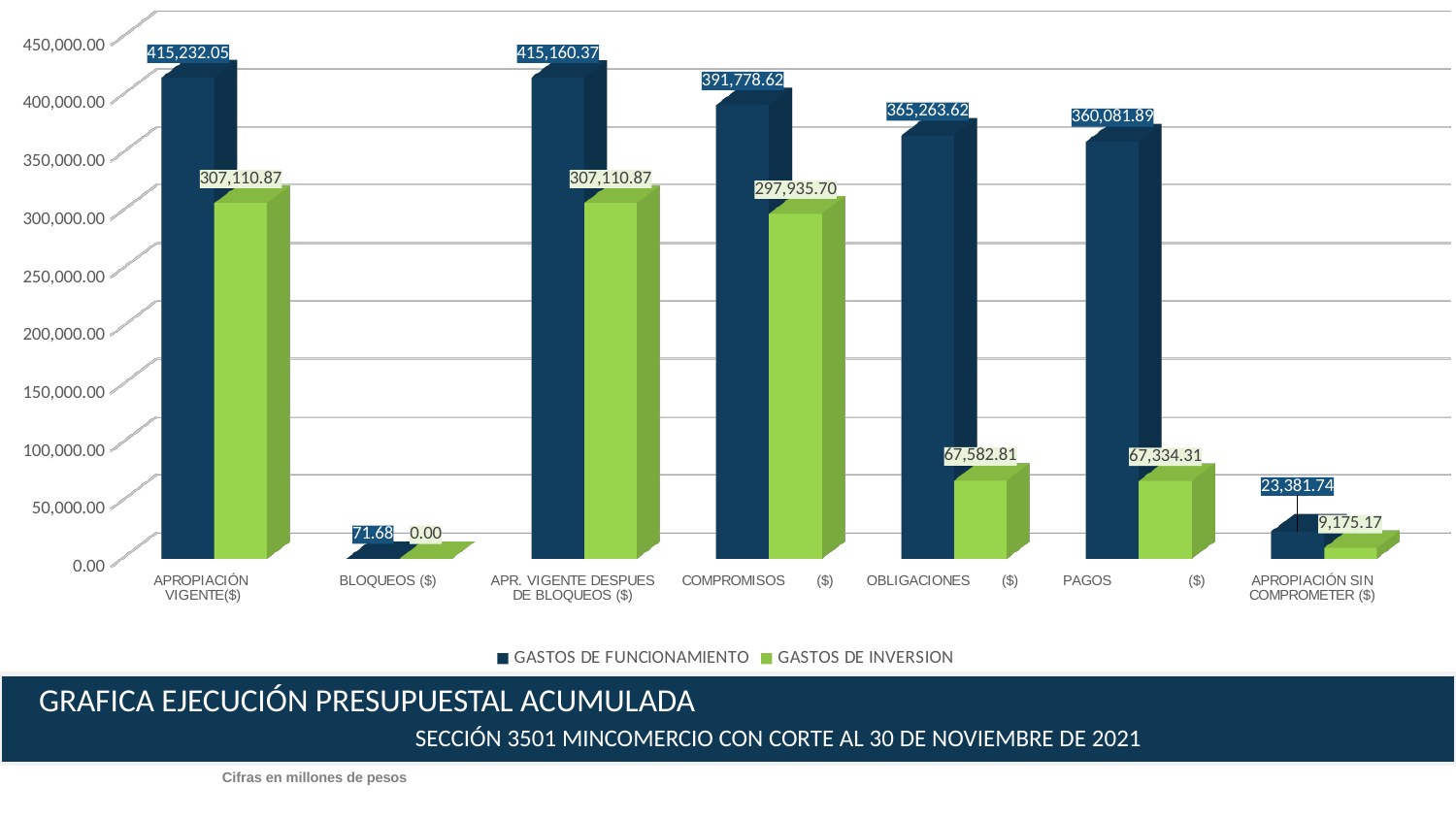
What type of chart is shown on the slide? Bar chart What is the value of GASTOS DE FUNCIONAMIENTO for APROPIACIÓN SIN COMPROMETER ($)? 23,381.74 What is the difference between GASTOS DE FUNCIONAMIENTO for OBLIGACIONES ($) and for PAGOS ($)? 5,181.73 What is the difference between GASTOS DE FUNCIONAMIENTO and GASTOS DE INVERSION for APROPIACIÓN VIGENTE($)? 108,121.18 What is the value of GASTOS DE FUNCIONAMIENTO for COMPROMISOS ($)? 391,778.62 How many categories are shown on the x axis? 7 Which is larger: GASTOS DE INVERSION for COMPROMISOS ($) or GASTOS DE INVERSION for OBLIGACIONES ($)? COMPROMISOS ($) How many series does the legend list? 2 What is the value of GASTOS DE INVERSION for OBLIGACIONES ($)? 67,582.81 What is the value of GASTOS DE INVERSION for BLOQUEOS ($)? 0.00 Which category has the lowest GASTOS DE FUNCIONAMIENTO value? BLOQUEOS ($) Which category has the highest GASTOS DE INVERSION value? APROPIACIÓN VIGENTE($) and APR. VIGENTE DESPUES DE BLOQUEOS ($) (both 307,110.87)